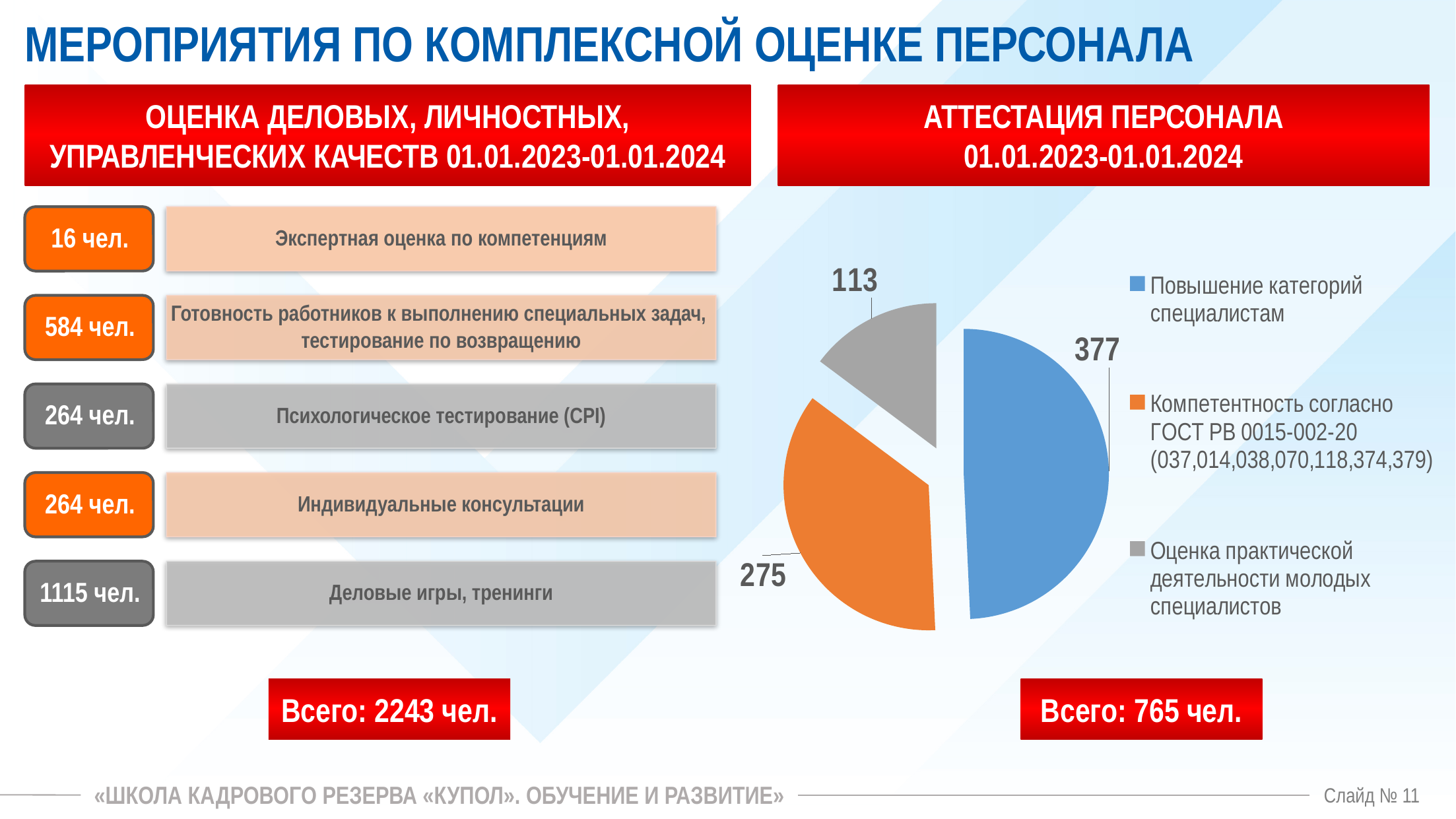
How many slices does the pie chart have? 3 In the pie chart, what is the value for Повышение категорий специалистам? 377 In the pie chart, what is the difference between the values for Повышение категорий специалистам and Компетентность согласно ГОСТ РВ 0015-002-20? 102 In the pie chart, what is the value for Оценка практической деятельности молодых специалистов? 113 Which category has the smallest slice in the pie chart? Оценка практической деятельности молодых специалистов Which category has the largest slice in the pie chart? Повышение категорий специалистам In the pie chart, which is larger: Компетентность согласно ГОСТ РВ 0015-002-20 or Оценка практической деятельности молодых специалистов? Компетентность согласно ГОСТ РВ 0015-002-20 In the pie chart, what is the difference between the values for Компетентность согласно ГОСТ РВ 0015-002-20 and Оценка практической деятельности молодых специалистов? 162 What type of chart is shown on the right side of the slide? Pie chart In the pie chart, what is the value for Компетентность согласно ГОСТ РВ 0015-002-20? 275 What is the total of all three values shown in the pie chart? 765 In the pie chart legend, which colour represents Оценка практической деятельности молодых специалистов? Grey